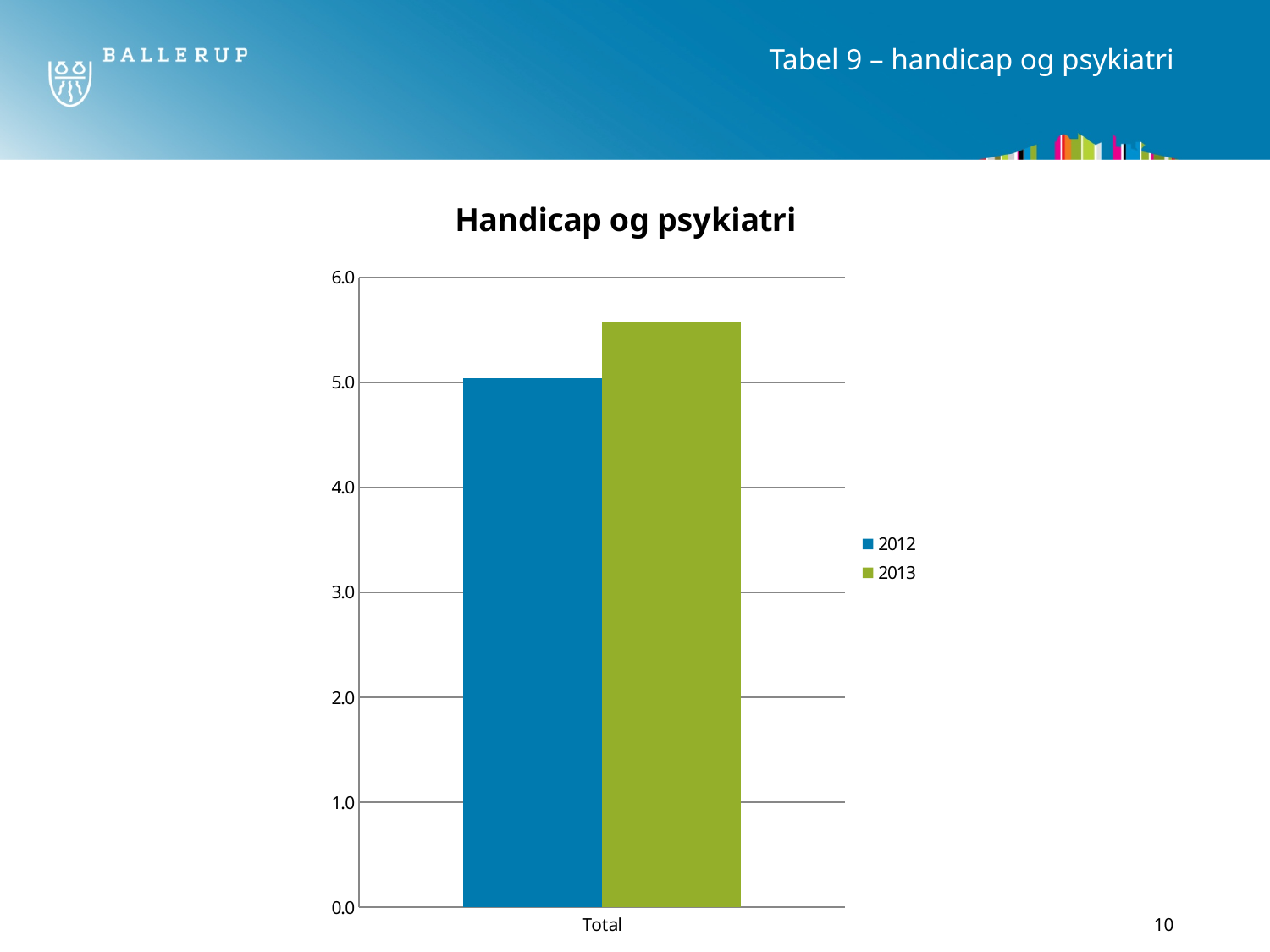
Which series is shown in green? 2013 What is the title of the chart? Handicap og psykiatri Is the value for 2013 in the Total category greater or less than 5.0? greater How many categories are shown on the x axis? 1 What is the label of the category on the x axis? Total How many series does the legend list? 2 Is the value for 2012 in the Total category greater or less than 6.0? less Which series has the higher value for Total, 2012 or 2013? 2013 Is the value for 2012 in the Total category greater or less than 4.0? greater What kind of chart is shown on the slide? bar chart What is the highest value shown on the y axis? 6.0